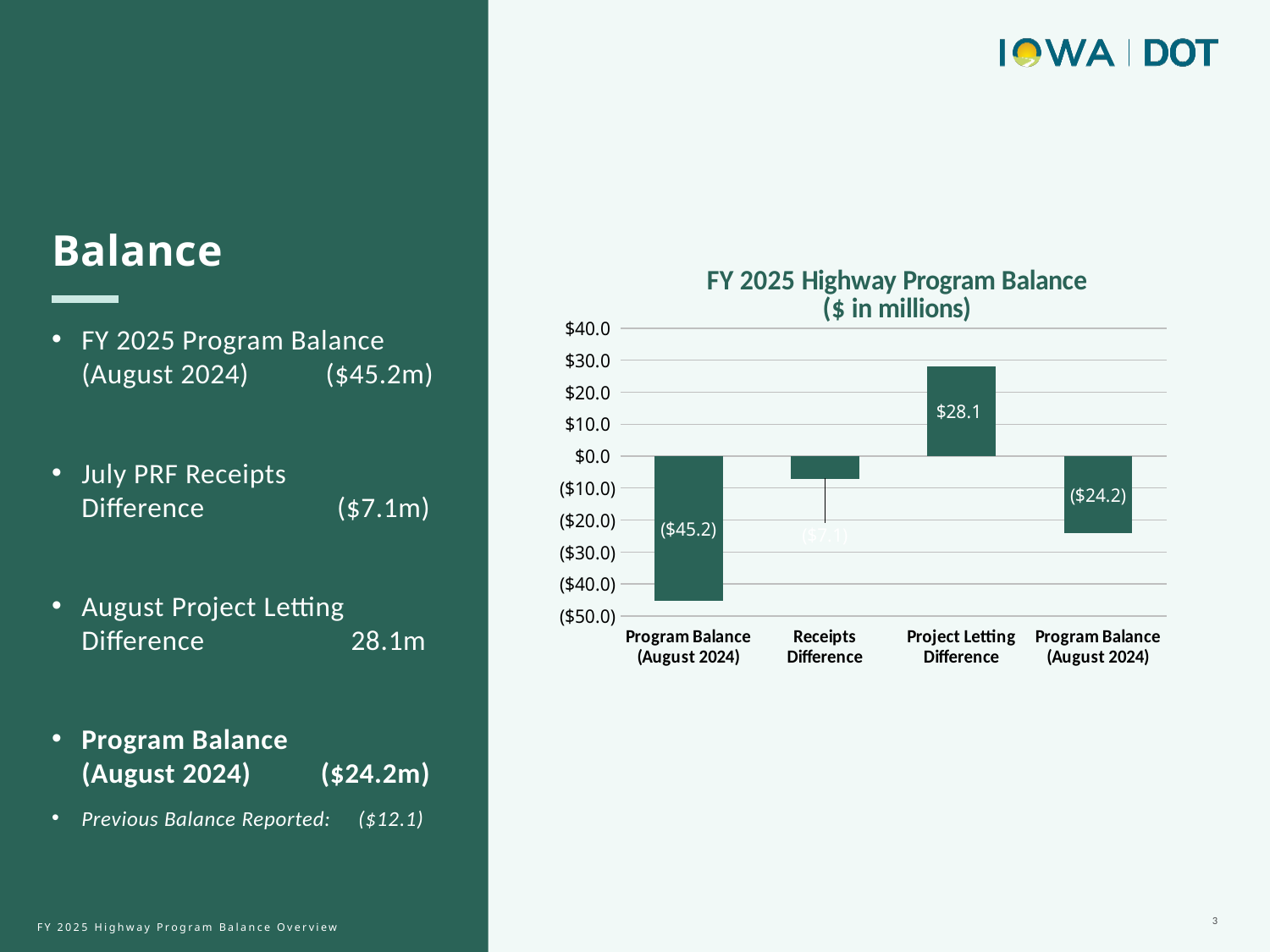
Which is larger, the value for Project Letting Difference or the value for Receipts Difference? Project Letting Difference How many bars are plotted in the chart? 4 How many of the bars in the chart have a positive value? 1 What is the value shown for Project Letting Difference? $28.1 What is the value shown for Receipts Difference? ($7.1) What is the value shown on the leftmost bar, Program Balance (August 2024)? ($45.2) Which bar extends furthest below zero in the chart? Program Balance (August 2024), the leftmost bar Which category has the highest value in the chart? Project Letting Difference Is the value for Project Letting Difference greater or less than $20.0? greater What is the value shown on the rightmost bar, Program Balance (August 2024)? ($24.2) What is the title of the chart? FY 2025 Highway Program Balance ($ in millions) What kind of chart is shown on the slide? bar chart